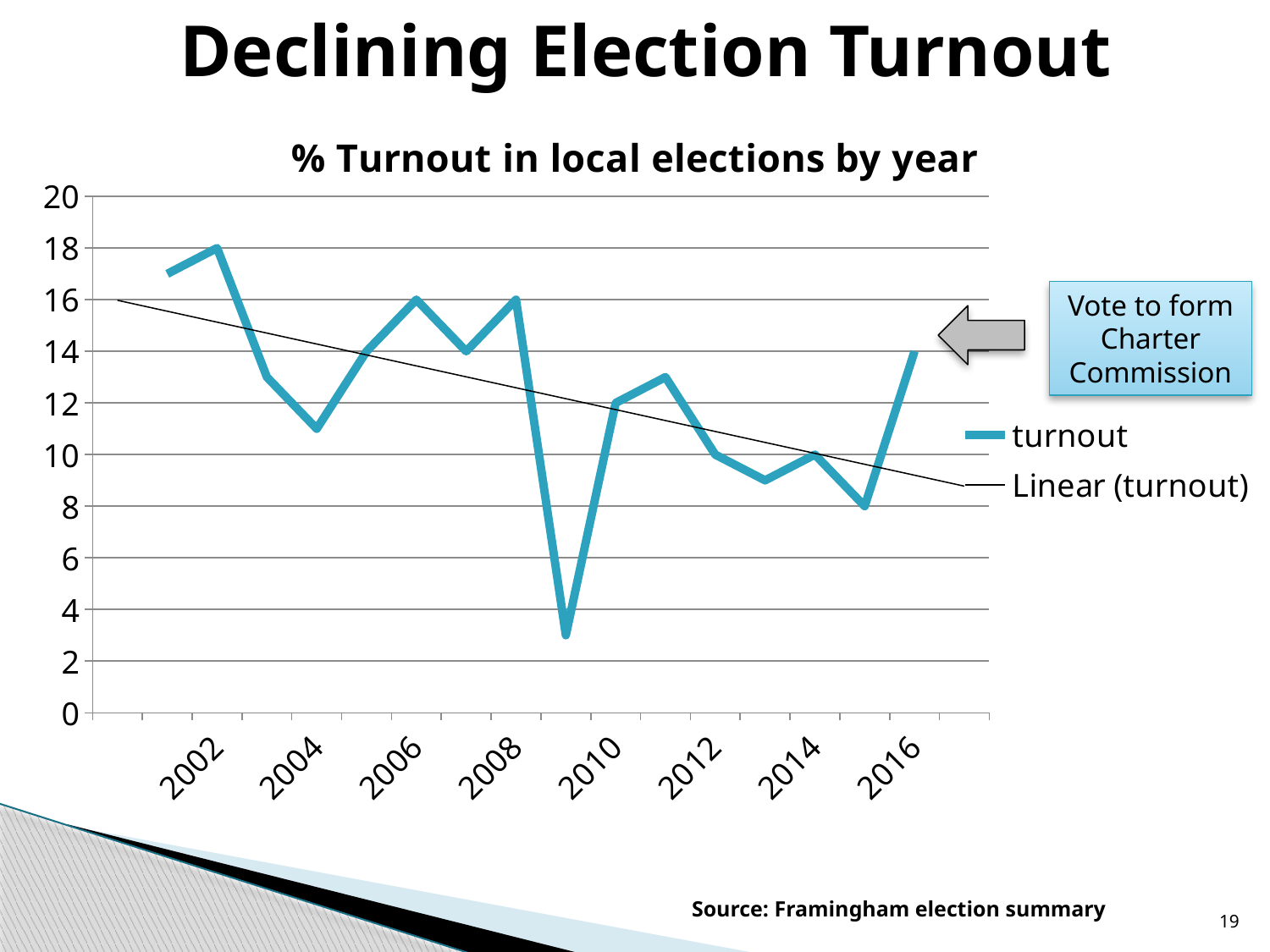
How many series does the legend list? 2 What is the turnout value for 2016? 14 What kind of chart is shown on the slide? line chart What are the two entries in the chart legend? turnout and Linear (turnout) Does the linear trend line for turnout rise or fall from 2002 to 2016? fall Which labelled year has the highest turnout? 2002 Which is larger, the turnout in 2002 or the turnout in 2016? 2002 What is the title of the chart? % Turnout in local elections by year Is the turnout value for 2006 greater or less than 14? greater Which is larger, the turnout in 2006 or the turnout in 2014? 2006 What is the turnout value for 2002? 18 Is the turnout value for 2004 greater or less than 12? less